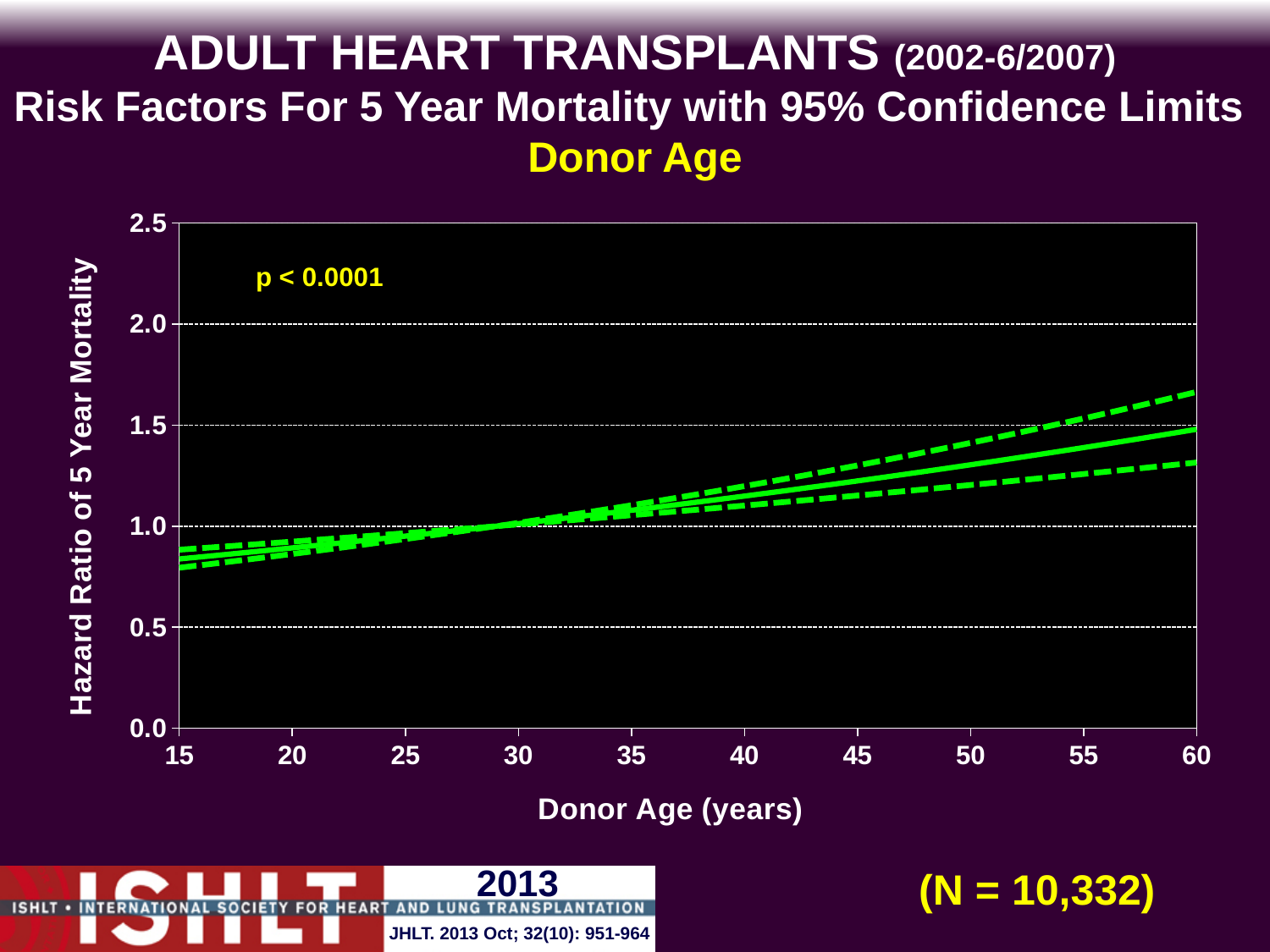
Is the hazard ratio on the solid line at donor age 60 greater or less than 1.0? greater Is the hazard ratio on the solid line at donor age 40 greater or less than 1.0? greater Is the hazard ratio on the solid line at donor age 15 greater or less than 1.0? less What is the label of the x axis? Donor Age (years) What is the p-value shown on the chart? p < 0.0001 How many tick labels are shown on the x axis? 10 Does the hazard ratio of 5 year mortality rise or fall as donor age increases from 15 to 60 years? rise What kind of chart is shown on the slide? line chart How many lines are plotted on the chart? 3